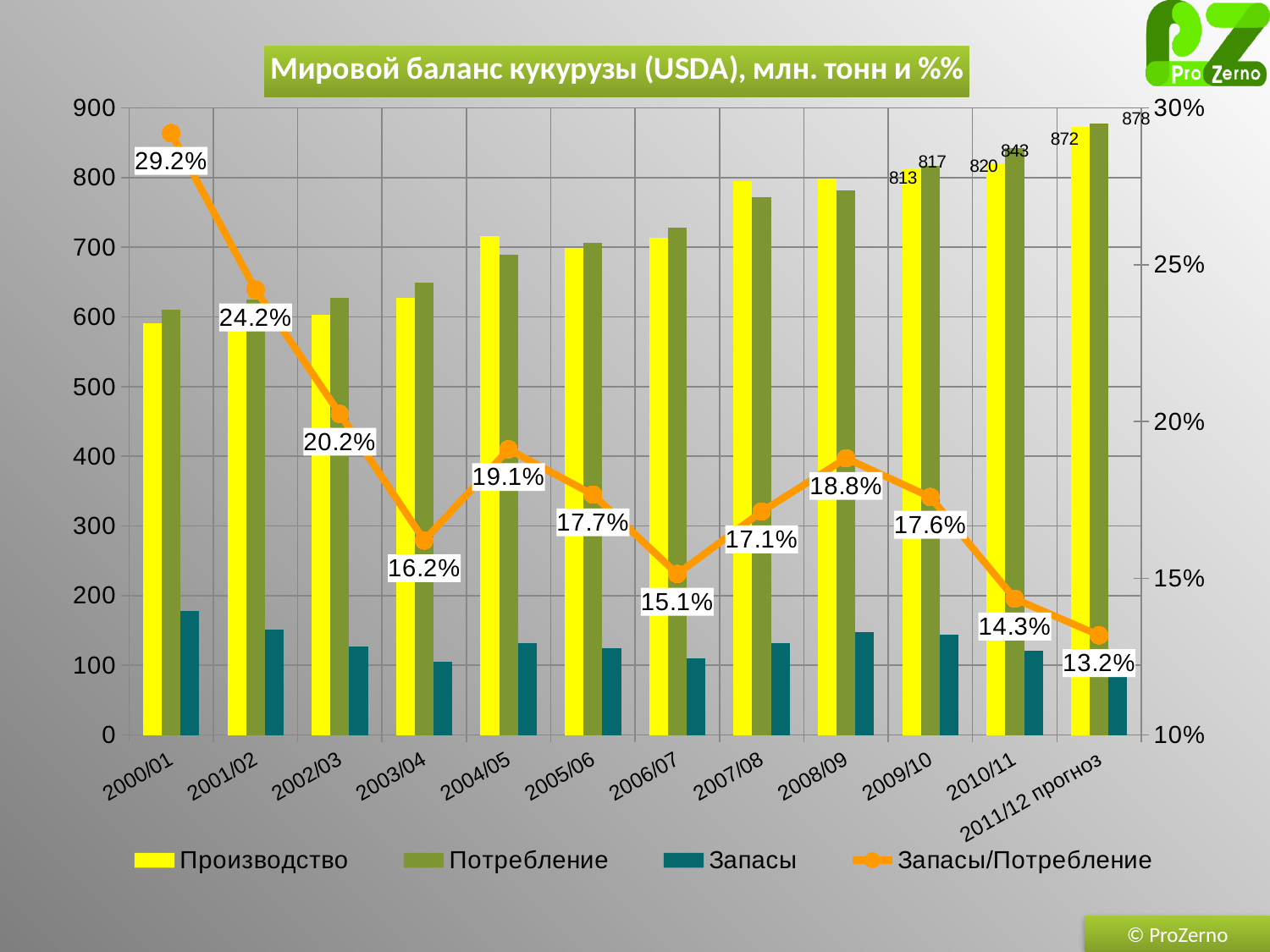
In which season is the Запасы/Потребление ratio highest? 2000/01 What is the difference between the Потребление and Производство values for 2010/11? 23 What is the Запасы/Потребление value for 2000/01? 29.2% Which is larger for 2009/10, Производство or Потребление? Потребление What is the title of the chart? Мировой баланс кукурузы (USDA), млн. тонн и %% What is the Производство value for 2010/11? 820 Is the Запасы value for 2000/01 greater or less than 200? less What is the Потребление value for 2011/12 прогноз? 878 How many seasons are shown on the x axis? 12 How many series does the legend list? 4 In which season is the Запасы/Потребление ratio lowest? 2011/12 прогноз What is the Запасы/Потребление value for 2011/12 прогноз? 13.2%